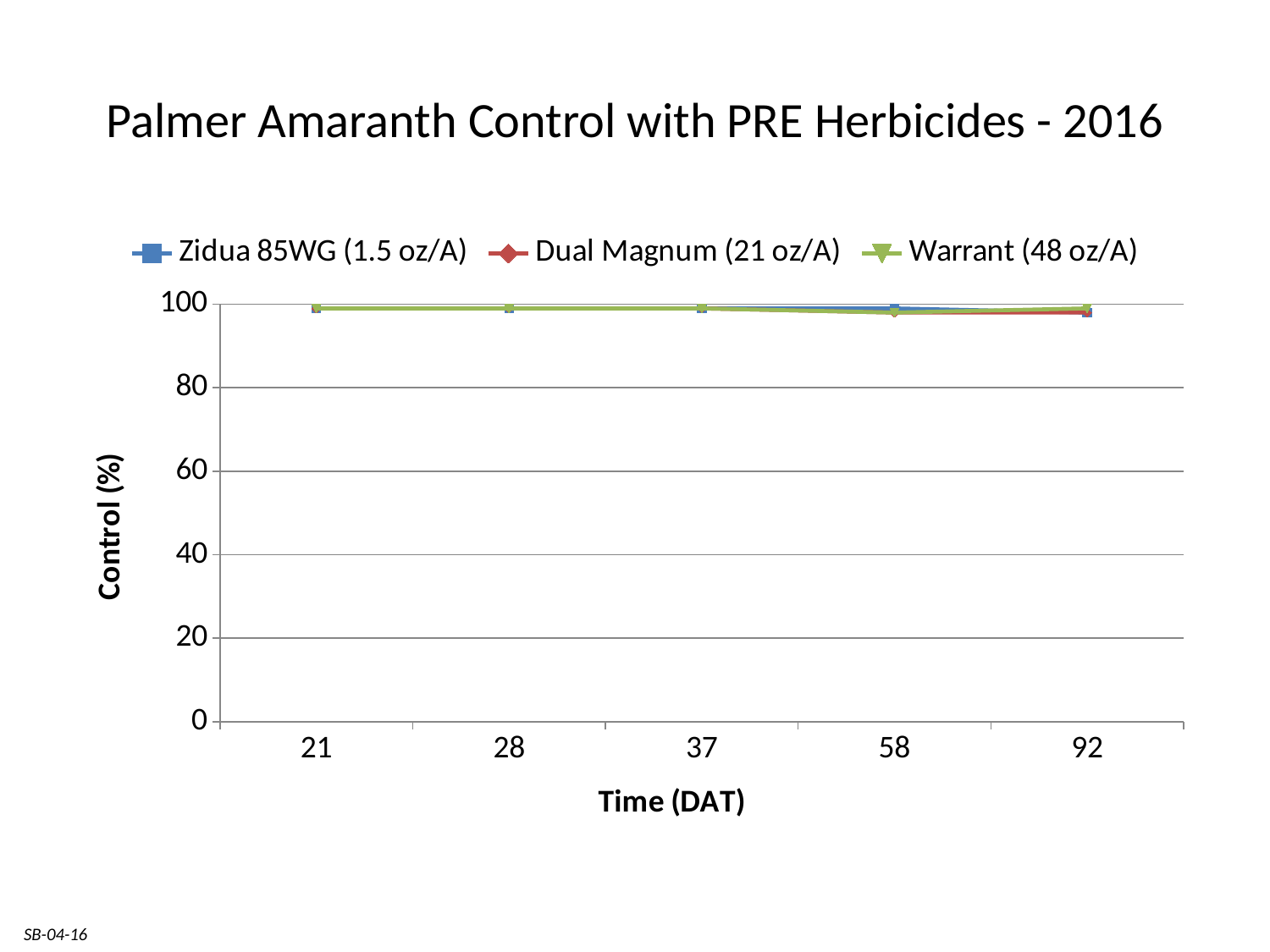
Do the control values for the three herbicides rise sharply, fall sharply, or stay roughly flat from 21 to 92 DAT? stay roughly flat What is the last time point shown on the x axis? 92 Is the value for Warrant (48 oz/A) at 58 DAT greater or less than 60? greater What is the first time point shown on the x axis? 21 What is the title of the chart? Palmer Amaranth Control with PRE Herbicides - 2016 Is the value for Zidua 85WG (1.5 oz/A) at 21 DAT greater or less than 80? greater How many time points (DAT) are plotted along the x axis? 5 Is the value for Dual Magnum (21 oz/A) at 92 DAT greater or less than 80? greater What is the label of the y axis? Control (%) What kind of chart is shown on the slide? line chart How many series does the legend list? 3